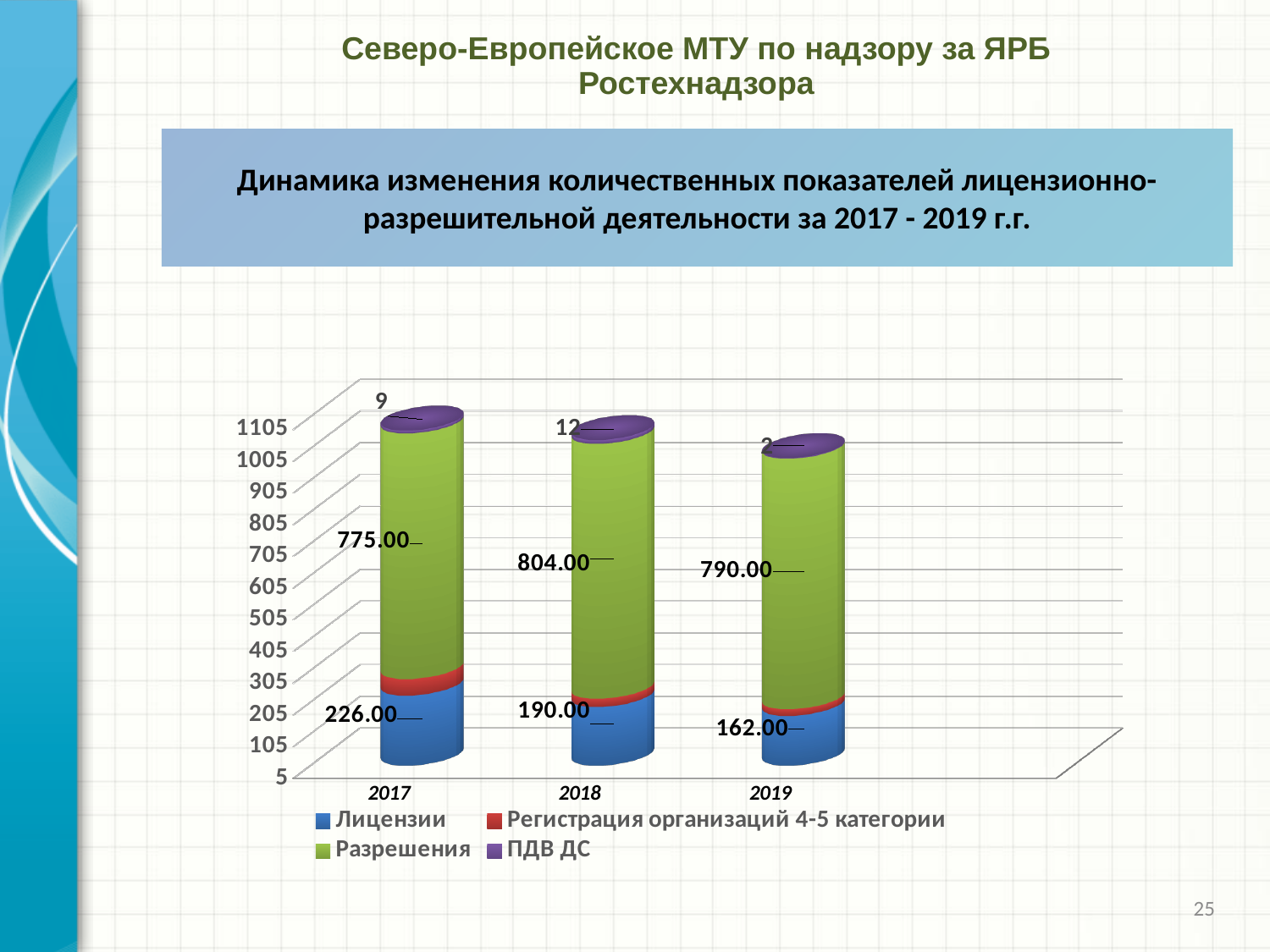
What is the value for ПДВ ДС in 2017? 9 What is the difference between the Лицензии values for 2017 and 2019? 64.00 How many series does the legend list? 4 What is the value for ПДВ ДС in 2018? 12 In which year is the value for Разрешения the highest? 2018 What kind of chart is shown on the slide? stacked bar chart What is the value for Разрешения in 2018? 804.00 In which year is the value for Лицензии the lowest? 2019 Do the values for Лицензии rise or fall from 2017 to 2019? fall Which year has the larger value for Лицензии, 2017 or 2018? 2017 How many years are shown on the x axis? 3 What is the value for Лицензии in 2017? 226.00